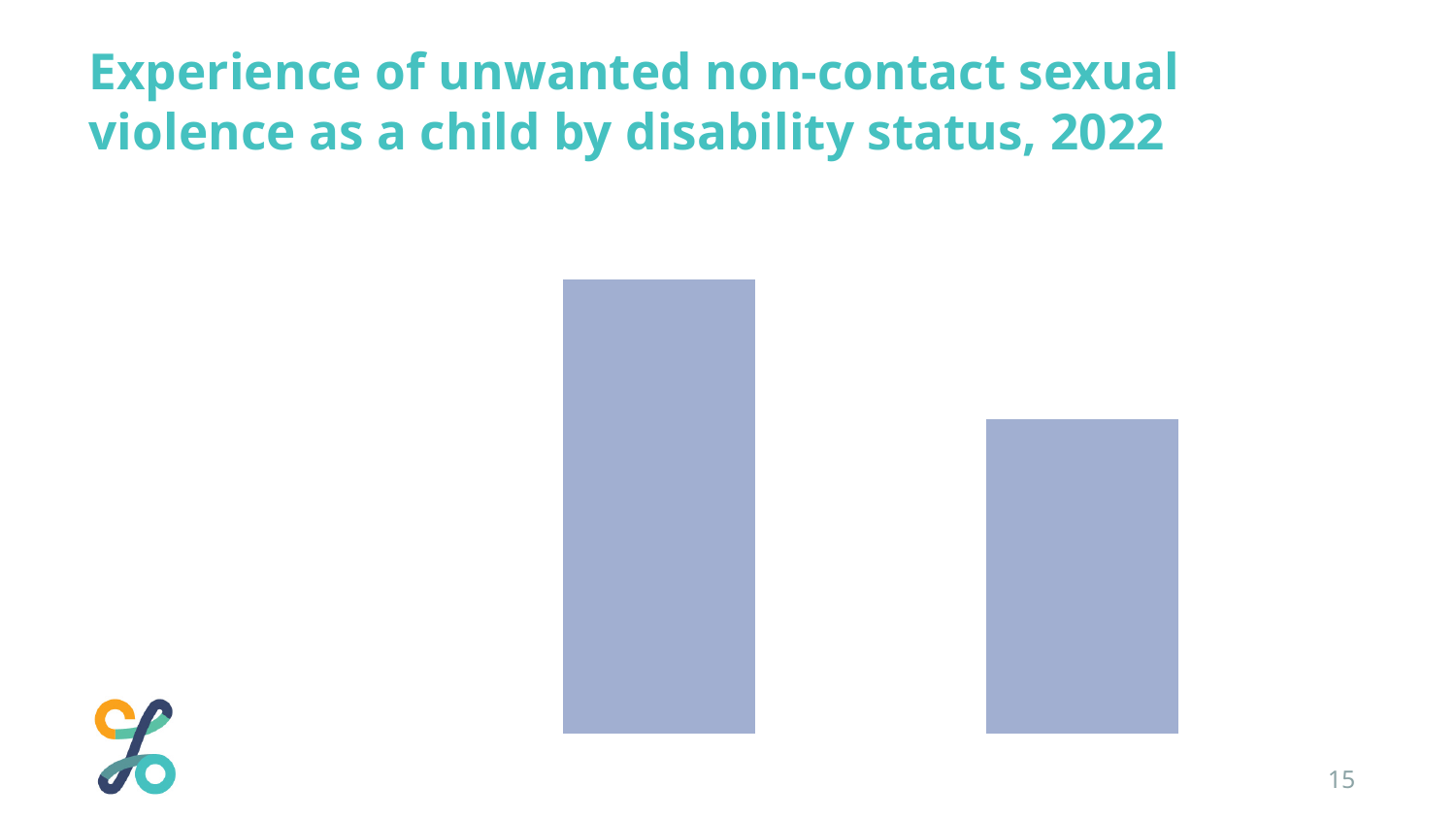
Do the bar values rise or fall from left to right? Fall What kind of chart is shown on the slide? Bar chart Which bar represents the lowest value? The right bar Which bar is taller, the left bar or the right bar? The left bar How many bars does the chart show? 2 What is the title of the chart on the slide? Experience of unwanted non-contact sexual violence as a child by disability status, 2022 Are the two bars the same colour? Yes Which bar represents the highest value? The left bar